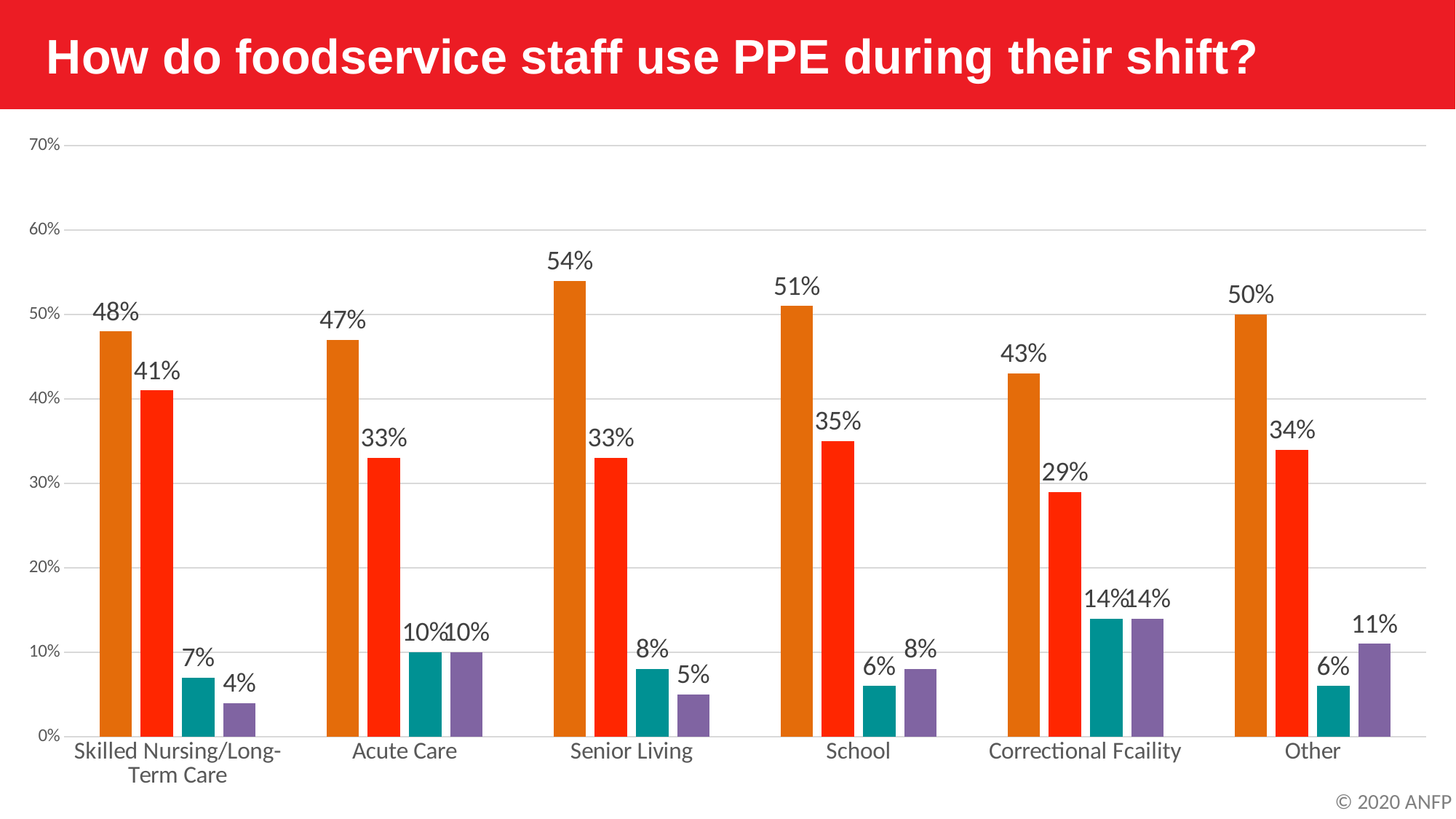
Which category has the highest orange bar? Senior Living What is the difference between the orange bar and the red bar for Skilled Nursing/Long-Term Care? 7% Which is larger: the orange bar for Acute Care or the orange bar for Other? Other What is the value of the purple bar for Other? 11% Is the value of the teal bar for Acute Care greater or less than 20%? less What is the value of the red bar for School? 35% What is the value of the orange bar for Senior Living? 54% Which category has the lowest orange bar? Correctional Fcaility What kind of chart is shown on the slide? bar chart Which category has the lowest purple bar? Skilled Nursing/Long-Term Care How many categories are shown on the x axis? 6 What is the value of the teal bar for Correctional Fcaility? 14%